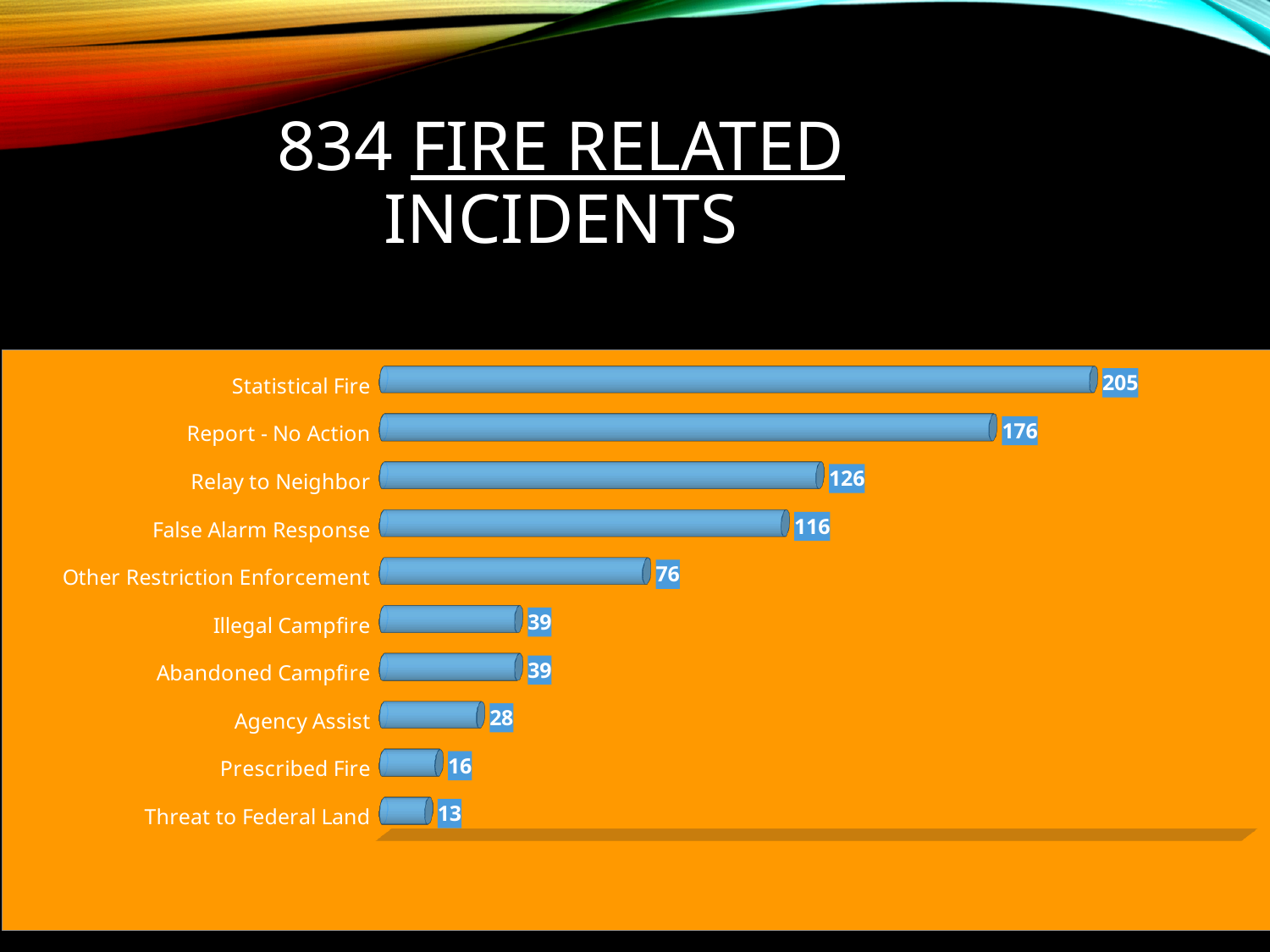
What is the value for Agency Assist? 28 What is the difference between the values for False Alarm Response and Other Restriction Enforcement? 40 Which category has the lowest value? Threat to Federal Land Which is larger, the value for Prescribed Fire or the value for Threat to Federal Land? Prescribed Fire What is the difference between the values for Statistical Fire and Report - No Action? 29 What kind of chart is shown on the slide? Bar chart Which category has the highest value? Statistical Fire What is the value for Statistical Fire? 205 What is the value for Relay to Neighbor? 126 What is the title of the slide? 834 Fire Related Incidents How many categories are shown in the chart? 10 Which is larger, the value for Relay to Neighbor or the value for False Alarm Response? Relay to Neighbor